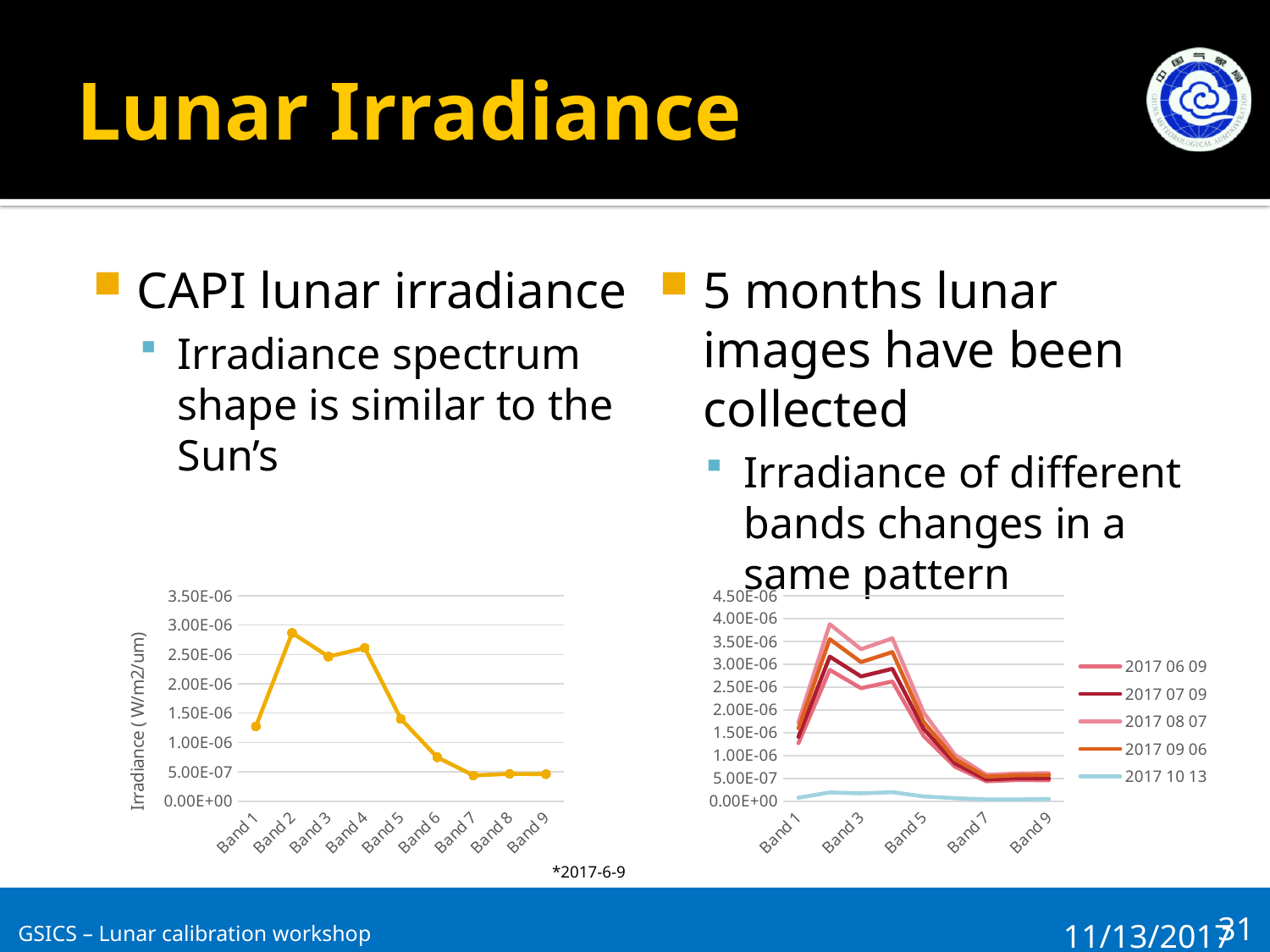
What kind of chart is the left chart on the slide? line chart In the left chart, how many bands are plotted along the x axis? 9 In the right chart, is the value of the 2017 08 07 series at Band 2 greater or less than 3.50E-06? greater In the right chart, which series has the lowest values across all bands? 2017 10 13 In the left chart, is the value for Band 6 greater or less than 1.00E-06? less In the left chart, do the values rise or fall from Band 4 to Band 7? fall In the left chart, is the value for Band 2 greater or less than 2.50E-06? greater In the left chart, which is larger, the value for Band 4 or the value for Band 5? Band 4 In the left chart, which band has the highest irradiance? Band 2 What is the y-axis label of the left chart? Irradiance ( W/m2/um) How many series does the legend of the right chart list? 5